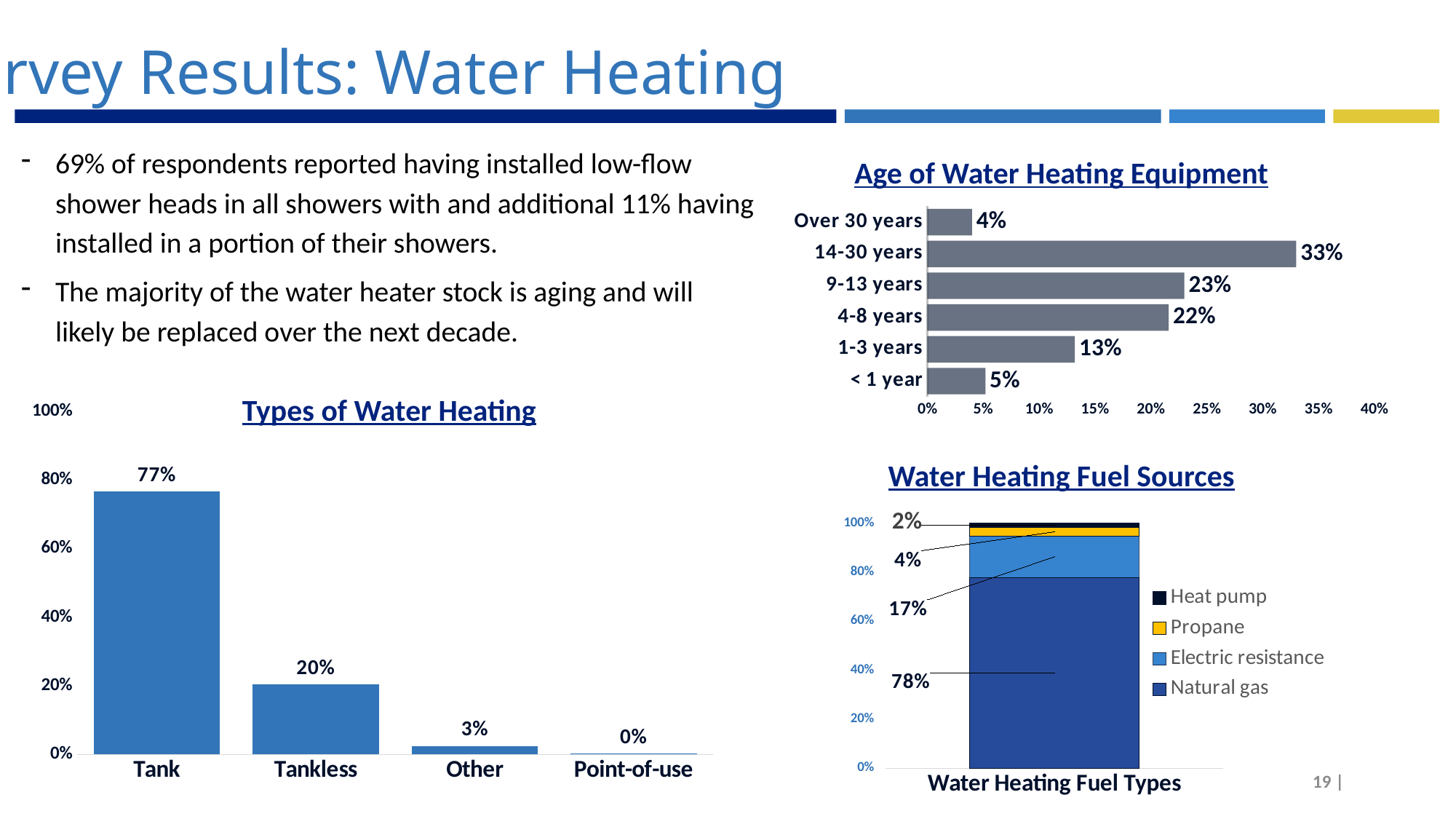
In the 'Water Heating Fuel Sources' chart, what is the value for Natural gas? 78% In the 'Types of Water Heating' chart, what is the value for Tankless? 20% In the 'Types of Water Heating' chart, what is the value for Tank? 77% In the 'Types of Water Heating' chart, what is the difference between Tank and Tankless? 57% What kind of chart is 'Age of Water Heating Equipment'? bar chart In the 'Age of Water Heating Equipment' chart, what is the value for 9-13 years? 23% In the 'Types of Water Heating' chart, how many categories are shown? 4 How many series does the legend of the 'Water Heating Fuel Sources' chart list? 4 In the 'Types of Water Heating' chart, which category has the lowest value? Point-of-use In the 'Age of Water Heating Equipment' chart, which category has the highest value? 14-30 years In the 'Age of Water Heating Equipment' chart, what is the difference between 14-30 years and Over 30 years? 29% In the 'Age of Water Heating Equipment' chart, which is larger, 1-3 years or < 1 year? 1-3 years